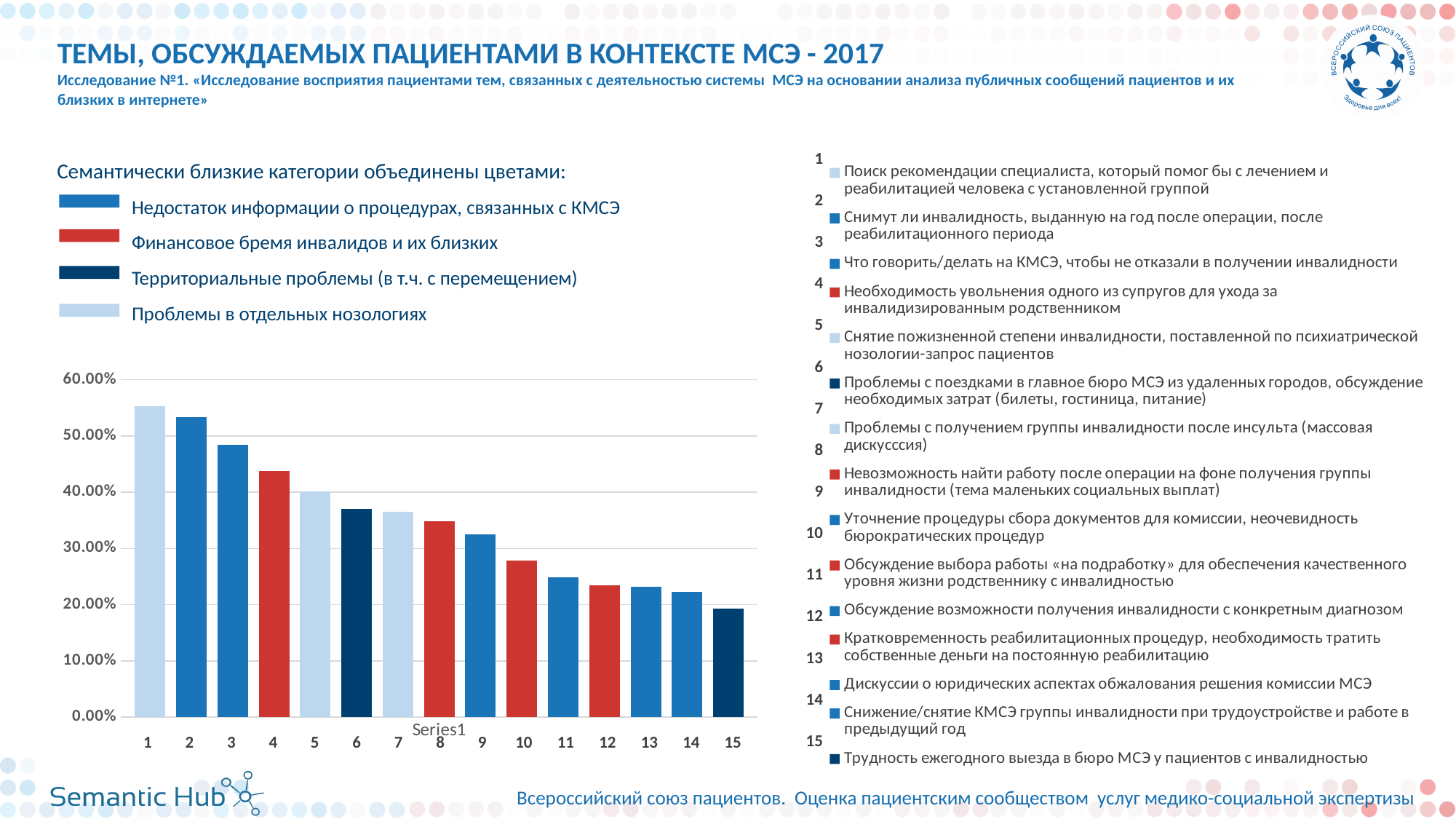
Which category has the lowest bar in the chart? 15 Which is larger, the value for category 9 or the value for category 11? category 9 Is the value for category 10 greater or less than 30.00%? less Do the bar values rise or fall as you move from category 1 to category 15 along the x axis? fall Which category has the highest bar in the chart? 1 Which is larger, the value for category 3 or the value for category 8? category 3 What kind of chart is shown on the slide? bar chart How many bars (categories) are plotted in the chart? 15 According to the legend, which topic group is shown in red? Финансовое бремя инвалидов и их близких Is the value for category 4 greater or less than 40.00%? greater Is the value for category 1 greater or less than 50.00%? greater